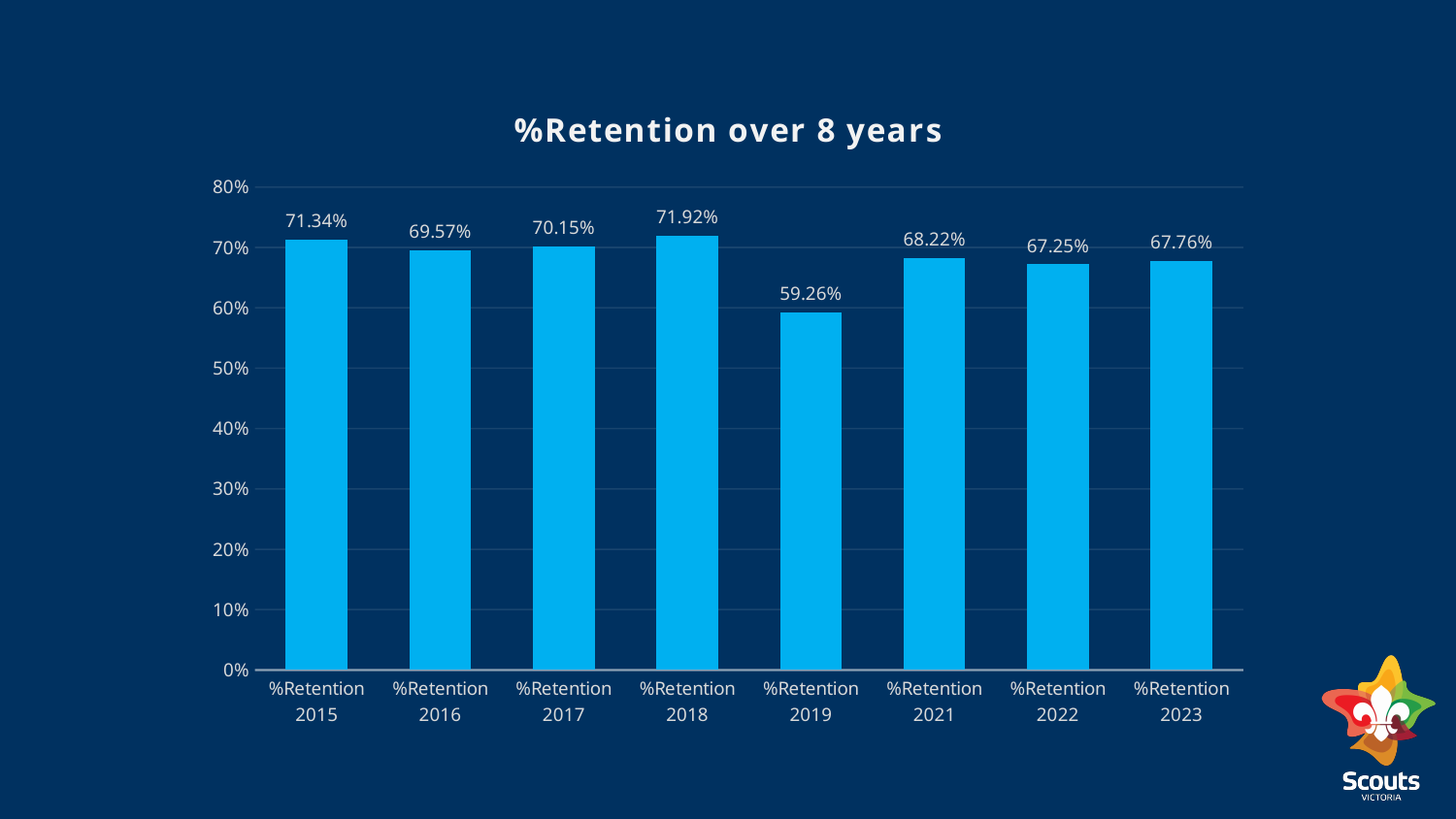
What is the retention value for %Retention 2019? 59.26% Is the value for %Retention 2021 greater or less than 60%? greater What is the difference between the retention values for %Retention 2018 and %Retention 2019? 12.66% How many categories are shown on the x axis? 8 What is the retention value for %Retention 2022? 67.25% Which category has the highest retention value? %Retention 2018 What kind of chart is shown on the slide? bar chart What is the retention value for %Retention 2015? 71.34% Which category has the lowest retention value? %Retention 2019 What is the title of the chart? %Retention over 8 years What is the difference between the retention values for %Retention 2023 and %Retention 2022? 0.51% Which is larger, the retention value for %Retention 2016 or %Retention 2017? %Retention 2017